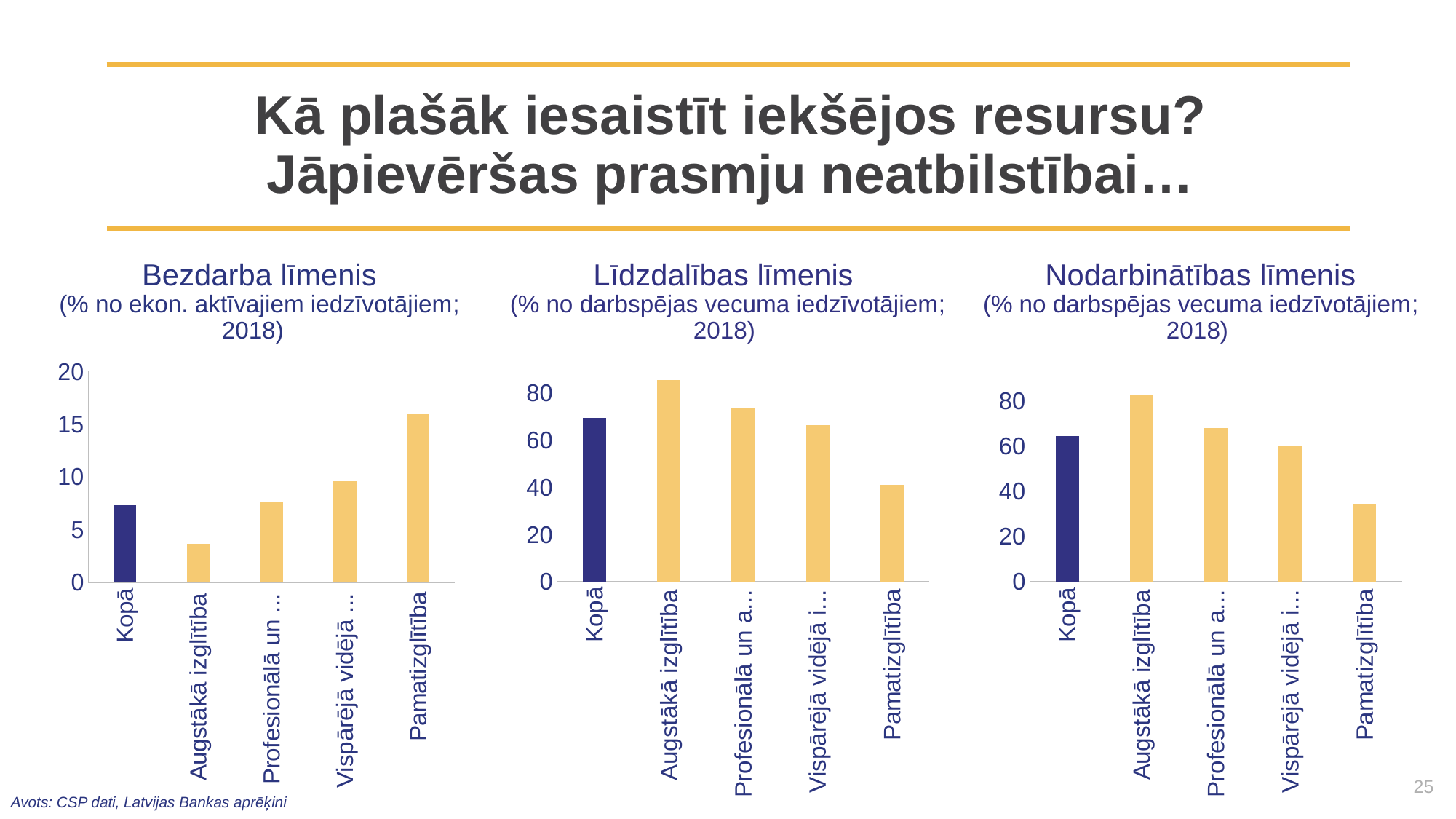
In the 'Nodarbinātības līmenis' chart, is the value for Pamatizglītība greater or less than 40? less In the 'Līdzdalības līmenis' chart, which category has the highest value? Augstākā izglītība What kind of chart is the 'Bezdarba līmenis' chart? bar chart In the 'Bezdarba līmenis' chart, is the value for Pamatizglītība greater or less than 15? greater In the 'Līdzdalības līmenis' chart, which category has the lowest value? Pamatizglītība How many categories are shown in the 'Līdzdalības līmenis' chart? 5 In the 'Bezdarba līmenis' chart, which category has the lowest value? Augstākā izglītība In the 'Līdzdalības līmenis' chart, is the value for Augstākā izglītība greater or less than 80? greater In the 'Nodarbinātības līmenis' chart, which is larger, the value for Kopā or the value for Augstākā izglītība? Augstākā izglītība In the 'Bezdarba līmenis' chart, which category has the highest value? Pamatizglītība In the 'Nodarbinātības līmenis' chart, which bar is coloured dark blue rather than yellow? Kopā